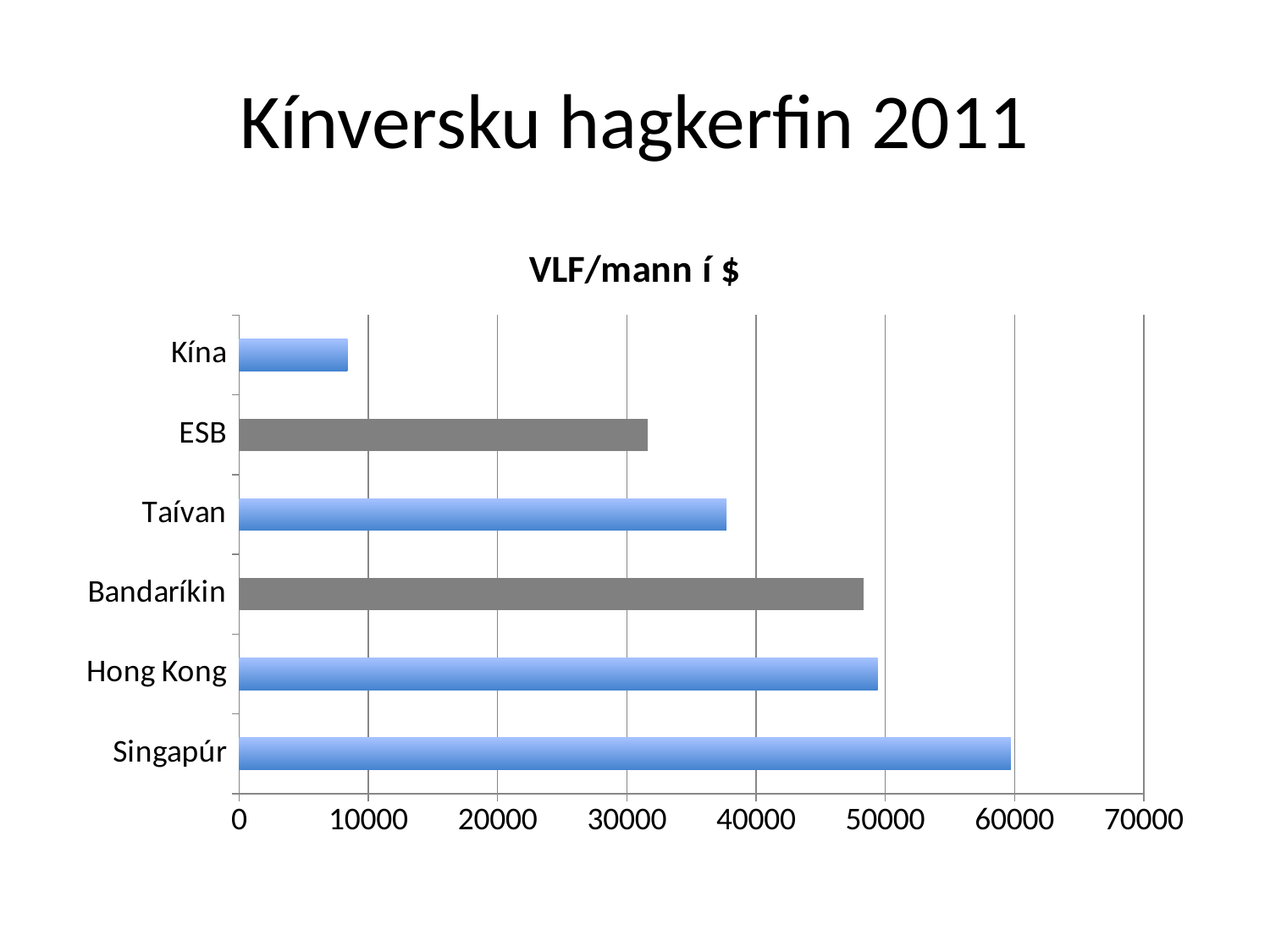
What kind of chart is shown on the slide? bar chart Which has a larger value, Taívan or ESB? Taívan Is the value for ESB greater or less than 30000? greater Which category has the lowest value? Kína Which category has the highest value? Singapúr Is the value for Taívan greater or less than 40000? less Which two categories are drawn with grey bars instead of blue? ESB and Bandaríkin Is the value for Singapúr greater or less than 50000? greater What is the title of the chart? VLF/mann í $ How many categories are plotted in the chart? 6